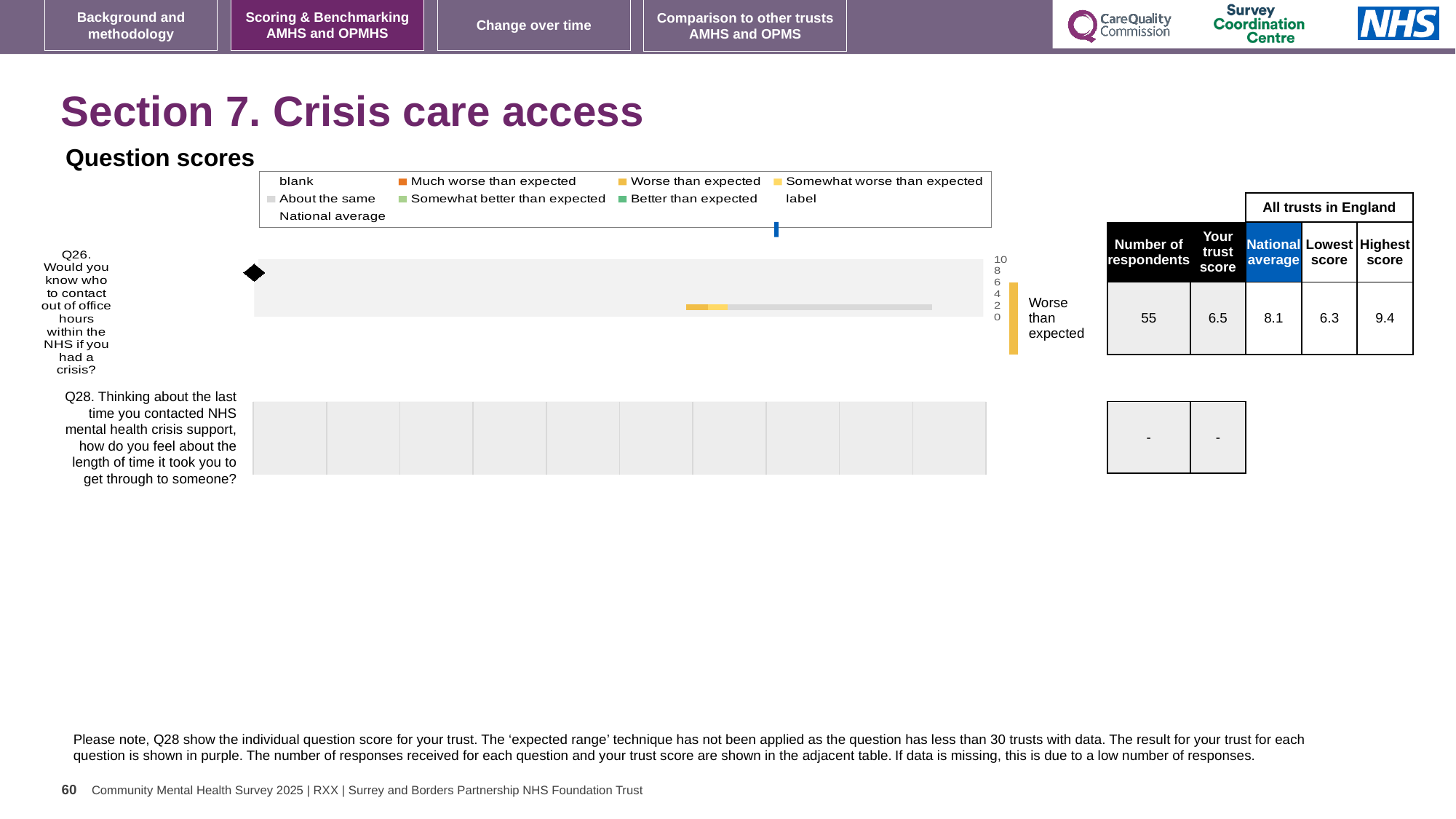
For Q26, which is larger: the trust score or the national average? National average What is the national average for Q26? 8.1 What is the difference between the highest and lowest scores for Q26? 3.1 How many respondents answered Q26? 55 What is the lowest score among all trusts in England for Q26? 6.3 Which expected-range category is the trust's Q26 score labelled as on the chart? Worse than expected What is the highest score among all trusts in England for Q26? 9.4 What is the difference between the national average and the trust score for Q26? 1.6 What is the trust score for Q26 shown in the table next to the chart? 6.5 What kind of chart is used to show the question scores on this slide? bar chart How many questions are plotted in the question scores chart? 2 What is shown for the number of respondents and trust score for Q28? -